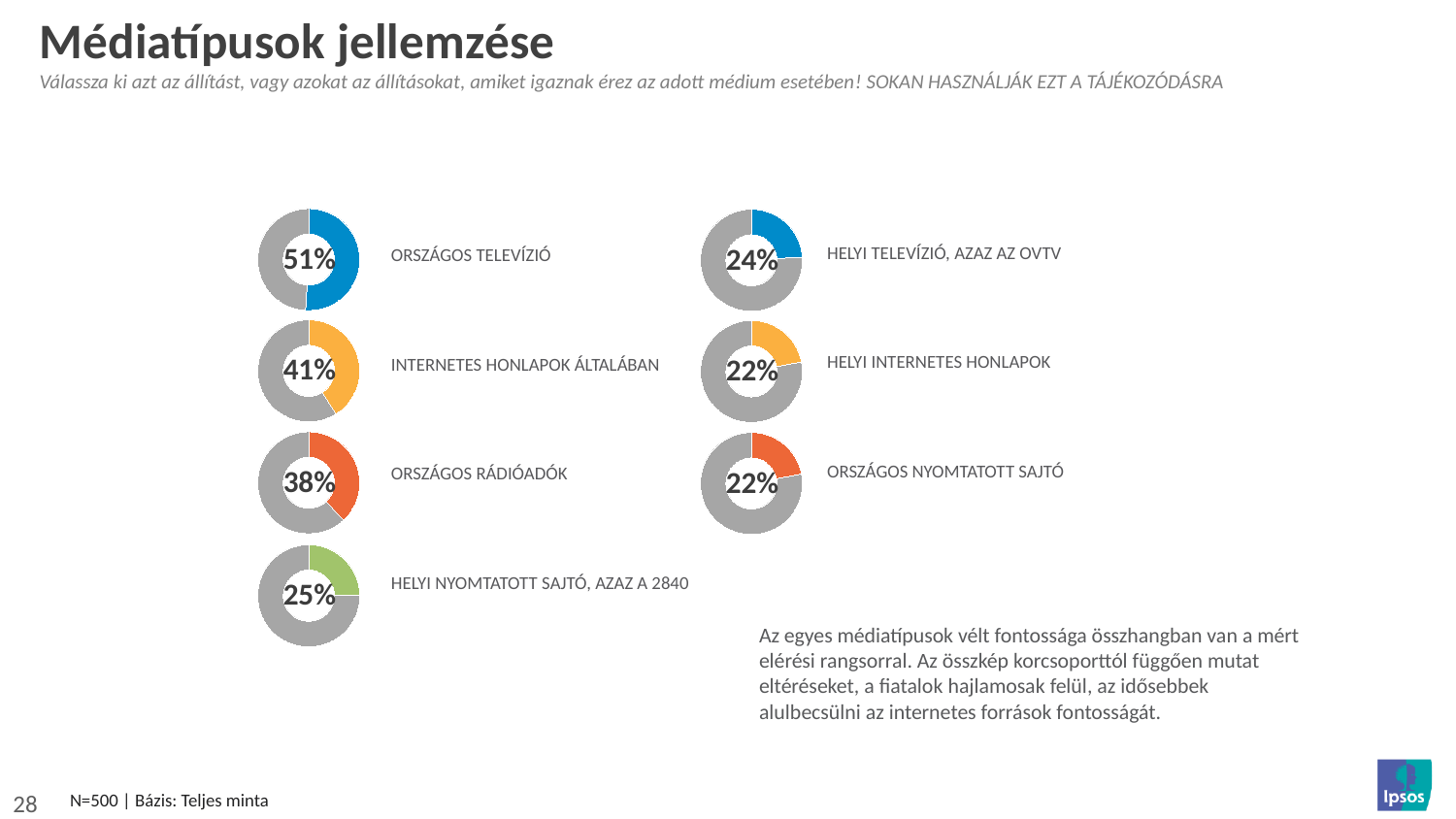
Which is larger: the percentage in the Országos rádióadók donut chart or the percentage in the Helyi televízió, azaz az OVTV donut chart? Országos rádióadók In the donut chart labelled Helyi nyomtatott sajtó, azaz a 2840, what percentage is shown? 25% In the donut chart labelled Internetes honlapok általában, what percentage is shown? 41% How many donut charts are shown on the slide? 7 In the donut chart labelled Országos nyomtatott sajtó, what percentage is shown? 22% Across all the donut charts on the slide, which media type has the highest percentage? Országos televízió In the donut chart labelled Helyi televízió, azaz az OVTV, what percentage is shown? 24% What is the difference between the percentage in the Országos televízió donut chart and the percentage in the Internetes honlapok általában donut chart? 10 percentage points In the donut chart labelled Országos televízió, what percentage is shown? 51% In the donut chart labelled Országos rádióadók, what percentage is shown? 38% What kind of chart is used to show the percentage for each media type on the slide? Donut (pie) chart In the donut chart labelled Helyi internetes honlapok, what percentage is shown? 22%